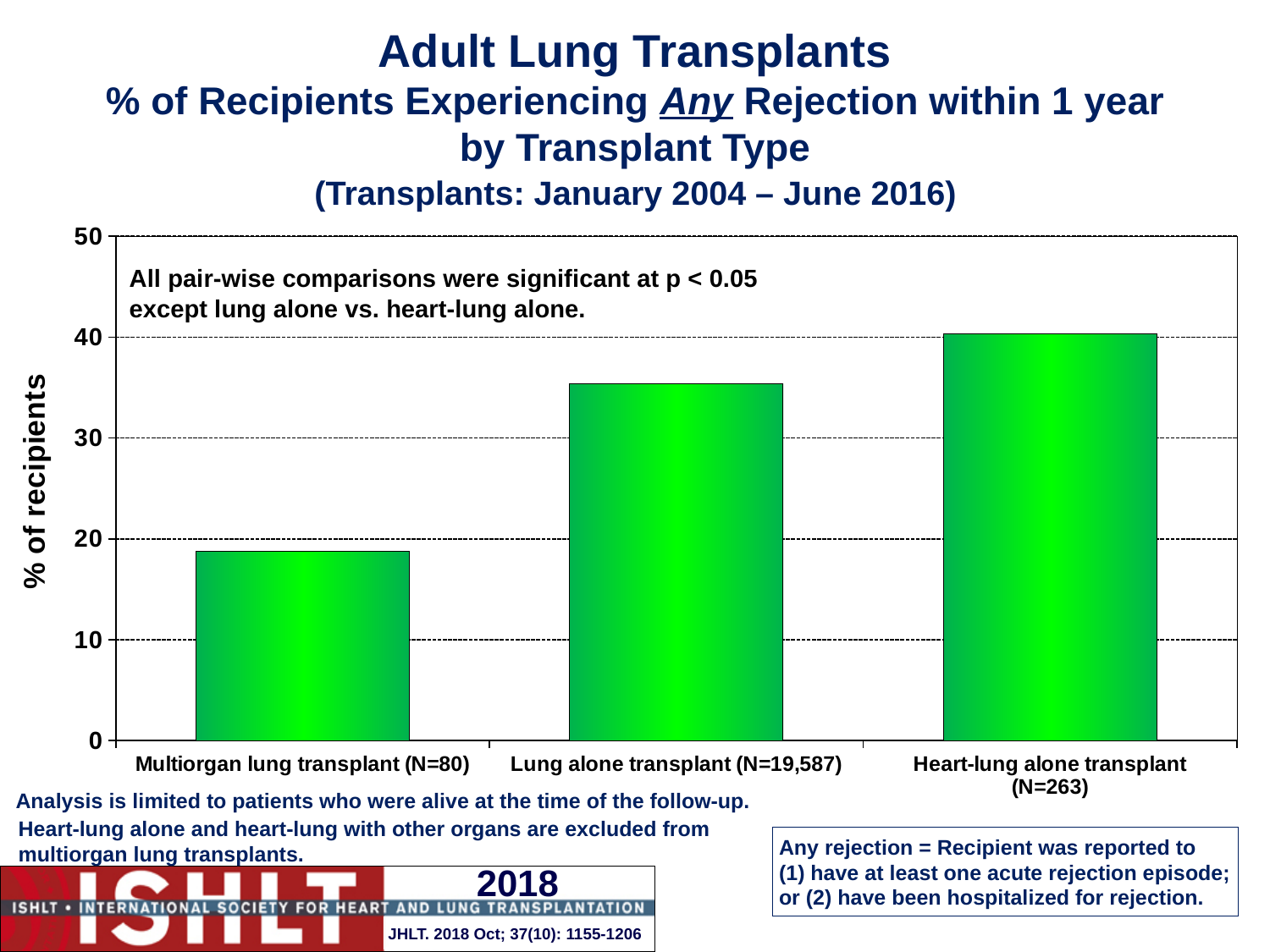
Which has a higher % of recipients experiencing any rejection: Lung alone transplant or Multiorgan lung transplant? Lung alone transplant Which transplant type has the lowest % of recipients experiencing any rejection within 1 year? Multiorgan lung transplant (N=80) What kind of chart is shown on the slide? bar chart Is the value for Lung alone transplant (N=19,587) greater or less than 30? greater Is the value for Lung alone transplant (N=19,587) greater or less than 40? less What is the label on the vertical axis of the chart? % of recipients Is the value for Heart-lung alone transplant (N=263) greater or less than 30? greater Which transplant type has the highest % of recipients experiencing any rejection within 1 year? Heart-lung alone transplant (N=263) Do the bar values rise or fall moving from left to right across the chart? rise How many transplant type categories are plotted in the chart? 3 Which has a higher % of recipients experiencing any rejection: Heart-lung alone transplant or Lung alone transplant? Heart-lung alone transplant